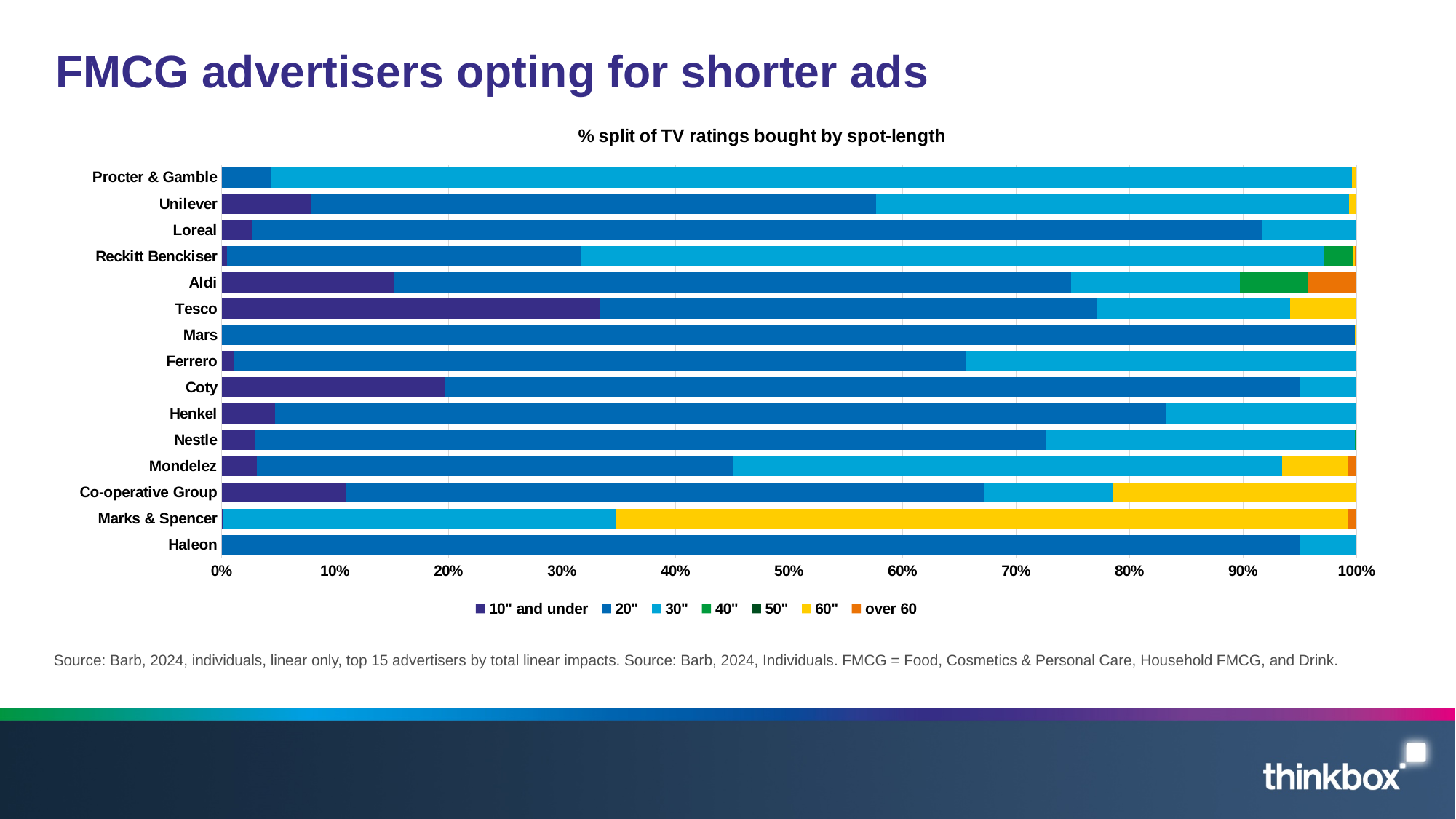
Is the 10" and under share for Tesco greater or less than 30%? greater Which advertiser has the largest share of 60" spots? Marks & Spencer How many advertisers are listed on the chart? 15 Is the 20" share for Haleon greater or less than 90%? greater Which advertiser has the largest share of 20" spots? Mars What kind of chart is shown on the slide? Stacked bar chart How many series does the legend list? 7 What is the title of the chart? % split of TV ratings bought by spot-length Which advertiser has the largest share of 10" and under spots? Tesco Is the 10" and under share for Aldi greater or less than 10%? greater Which has the larger share of 10" and under spots, Tesco or Aldi? Tesco